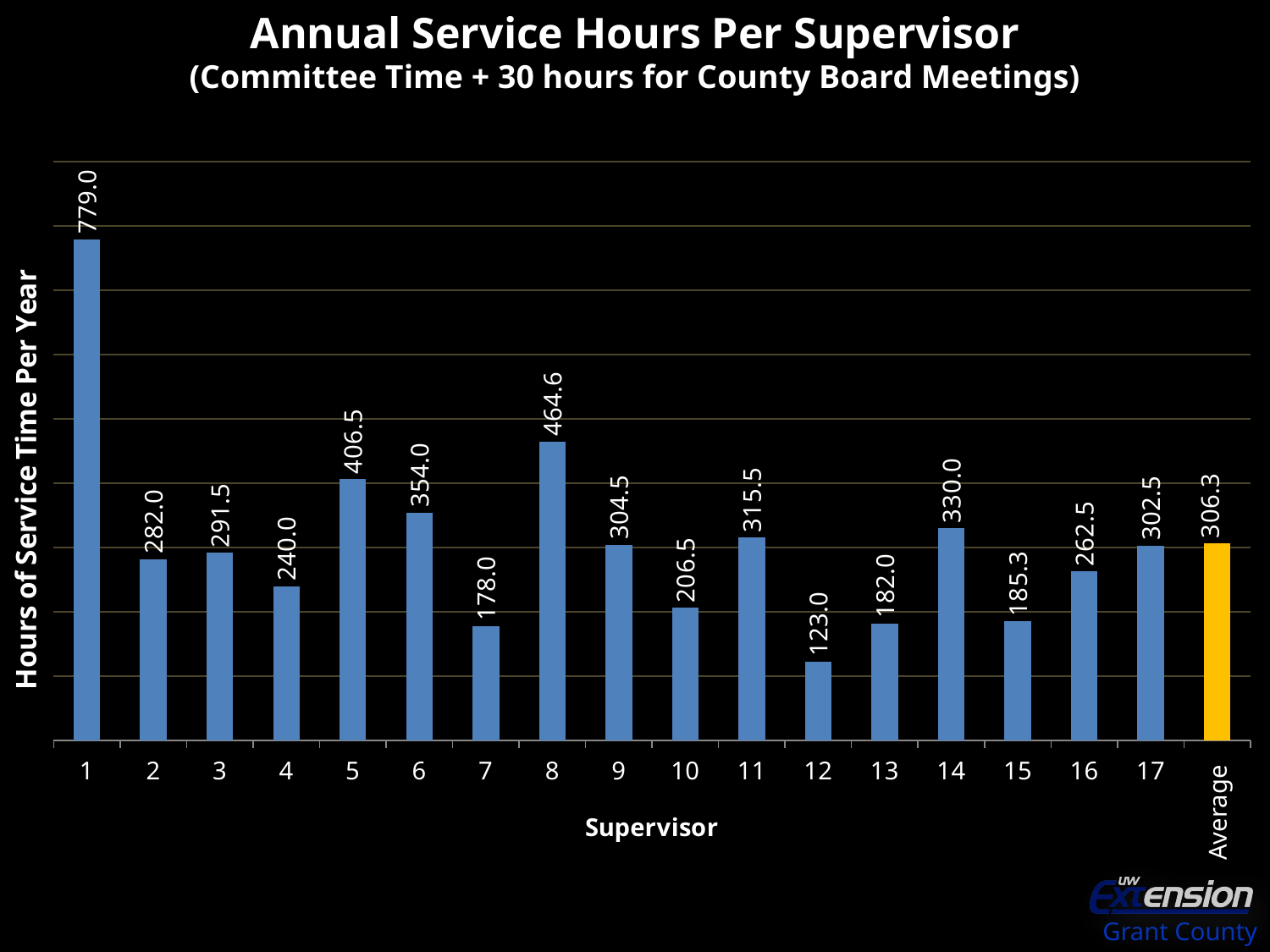
Which bar is coloured differently (yellow) from the others? Average Which supervisor has the highest annual service hours? 1 Which has more service hours, Supervisor 14 or Supervisor 11? Supervisor 14 What is the label of the y axis? Hours of Service Time Per Year What kind of chart is shown on the slide? Bar chart What is the annual service hours value for Supervisor 1? 779.0 What is the value shown for the Average bar? 306.3 How many bars are plotted on the chart, including the Average bar? 18 What is the difference in service hours between Supervisor 8 and Supervisor 5? 58.1 What is the difference in service hours between Supervisor 1 and the Average? 472.7 What is the annual service hours value for Supervisor 12? 123.0 Which supervisor has the lowest annual service hours? 12